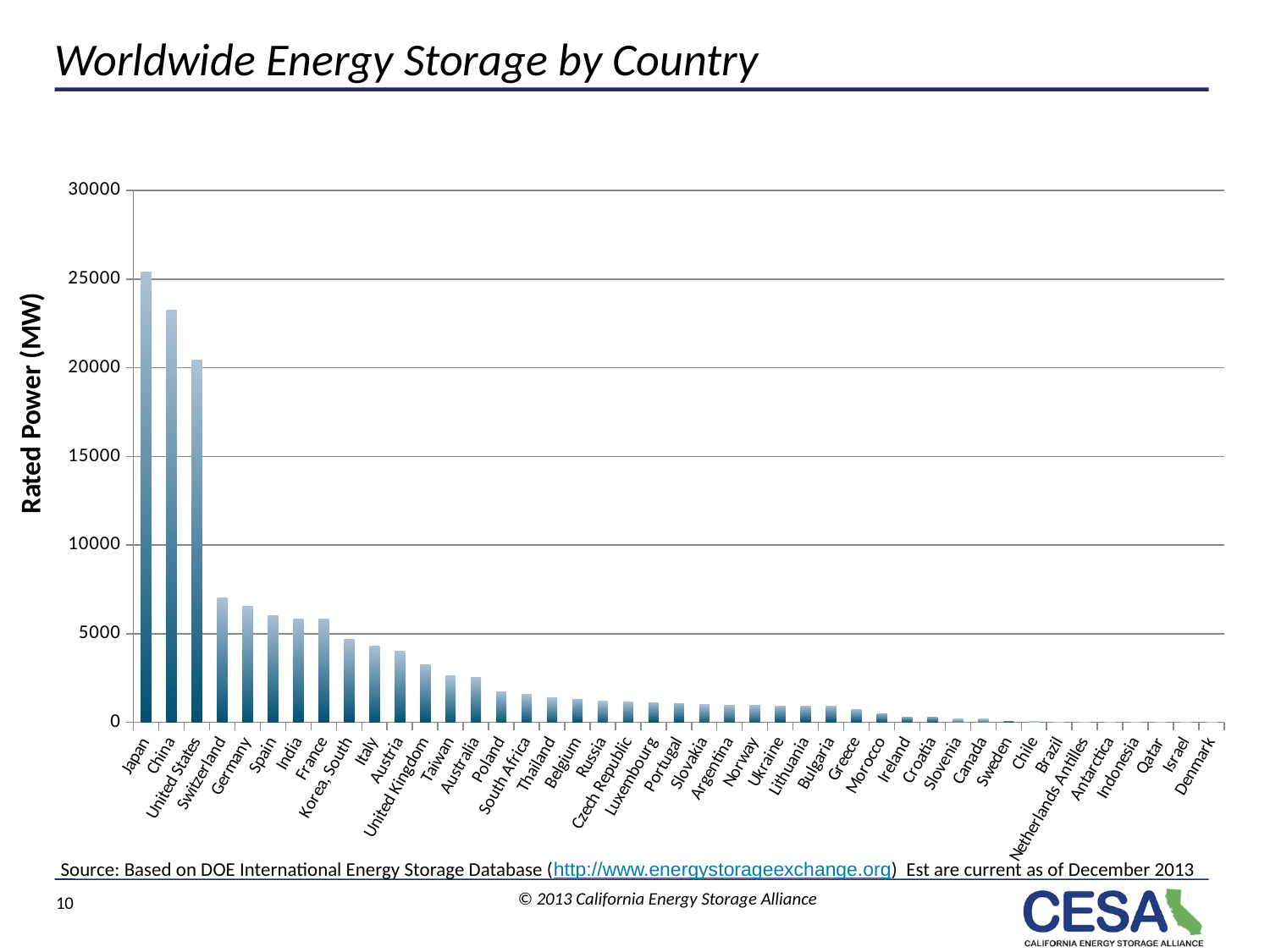
How many countries are shown on the x axis of the chart? 43 Which has a larger rated power, Japan or China? Japan Is the value for Japan greater or less than 20000? greater Is the value for Italy greater or less than 5000? less Which has a larger rated power, United States or Switzerland? United States Do the values rise or fall moving from left to right along the x axis? fall Which country has the highest rated power in the chart? Japan Is the value for Germany greater or less than 5000? greater What is the label of the vertical axis? Rated Power (MW) What kind of chart is shown on the slide? bar chart